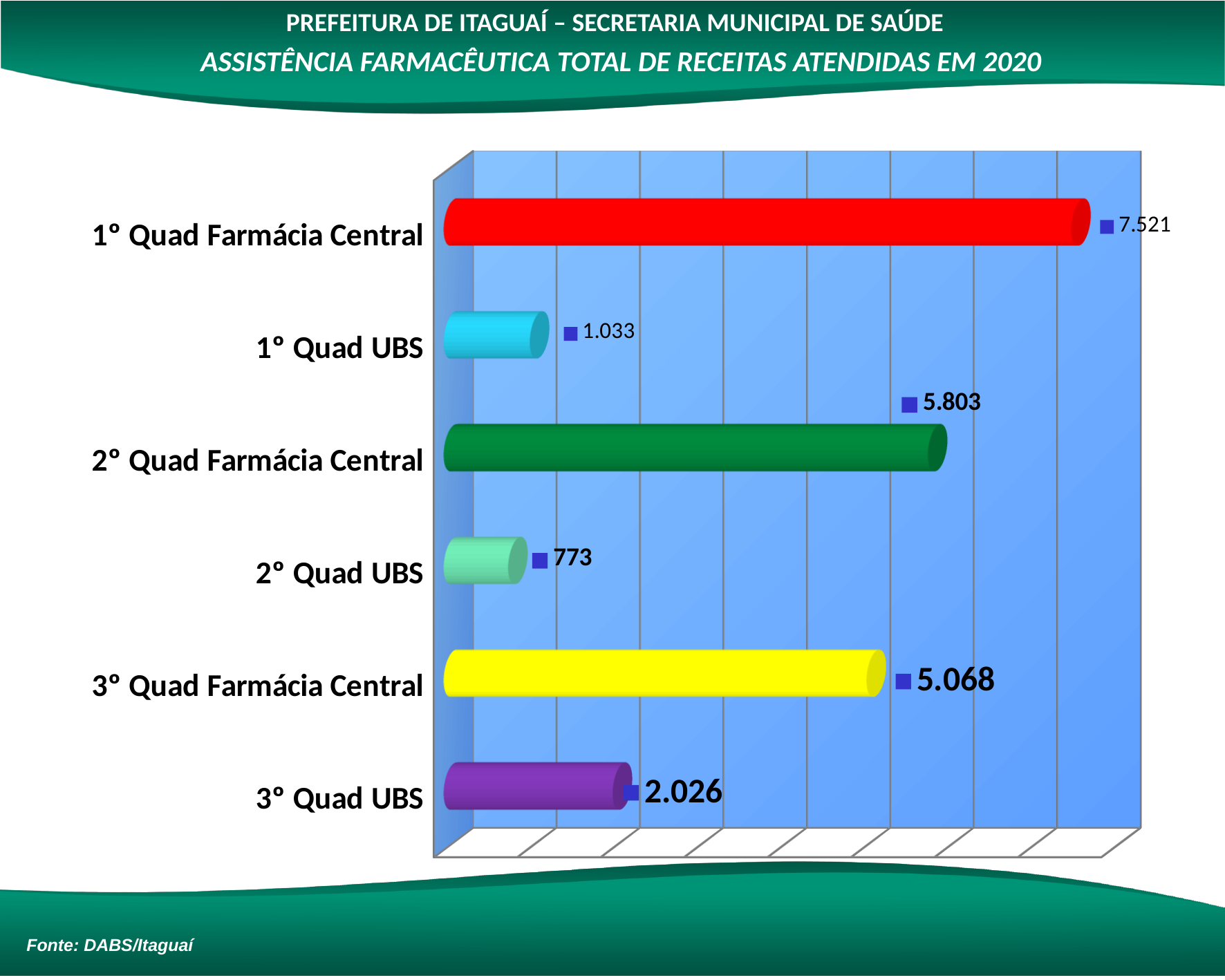
What kind of chart is shown on the slide? Bar chart What is the value for 1° Quad Farmácia Central? 7.521 What is the difference between the values for 1° Quad Farmácia Central and 2° Quad Farmácia Central? 1.718 What is the value for 3° Quad UBS? 2.026 What is the difference between the values for 3° Quad UBS and 2° Quad UBS? 1.253 Which category has the highest value? 1° Quad Farmácia Central What is the value for 2° Quad UBS? 773 Which is larger, the value for 2° Quad Farmácia Central or the value for 3° Quad Farmácia Central? 2° Quad Farmácia Central How many categories are shown in the chart? 6 What is the value for 3° Quad Farmácia Central? 5.068 Which is larger, the value for 1° Quad UBS or the value for 3° Quad UBS? 3° Quad UBS Which category has the lowest value? 2° Quad UBS